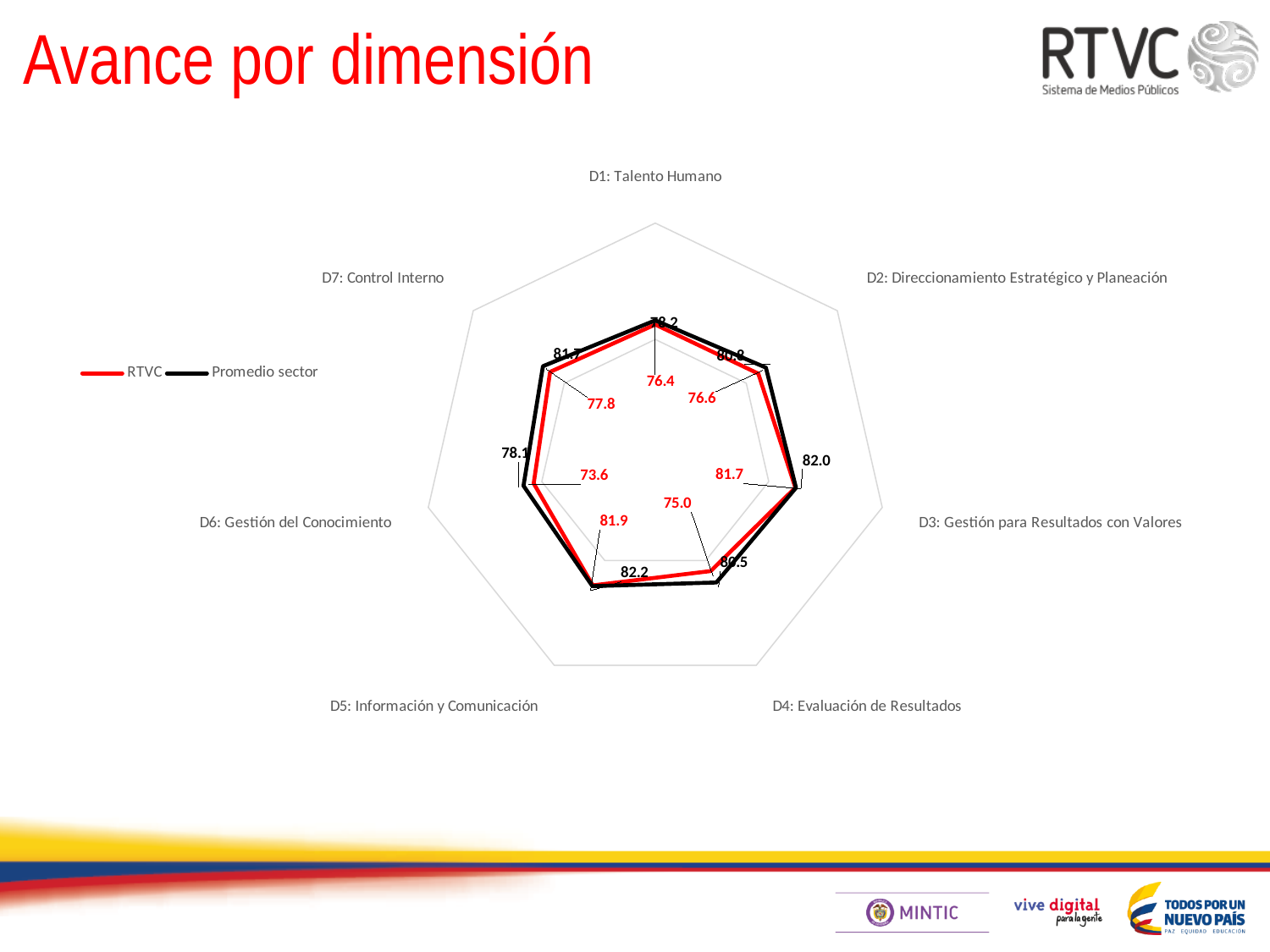
What is the RTVC value for D5: Información y Comunicación? 81.9 How many series does the legend list? 2 What is the RTVC value for D4: Evaluación de Resultados? 75.0 Which dimension has the lowest RTVC value? D6: Gestión del Conocimiento For D5: Información y Comunicación, which series has the larger value, RTVC or Promedio sector? Promedio sector What is the Promedio sector value for D3: Gestión para Resultados con Valores? 82.0 How many dimensions (categories) are plotted on the radar chart? 7 What is the Promedio sector value for D6: Gestión del Conocimiento? 78.1 What kind of chart is shown on the slide? Radar chart What colour is the RTVC series line in the chart? Red What is the difference between the Promedio sector and RTVC values for D6: Gestión del Conocimiento? 4.5 What is the RTVC value for D6: Gestión del Conocimiento? 73.6